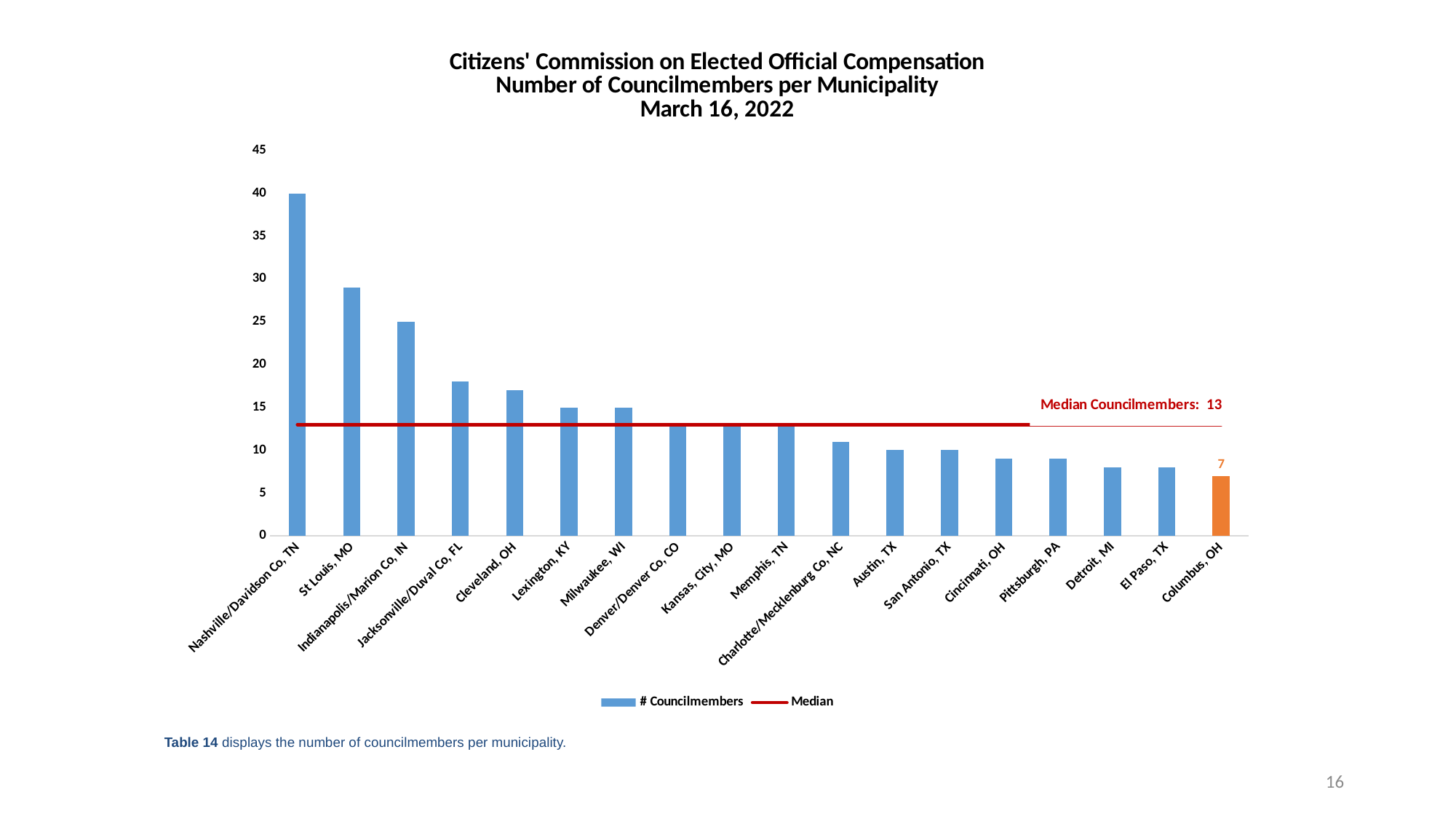
What kind of chart is shown on the slide? Combination bar and line chart (bars with a median line) What is the median number of councilmembers shown on the chart? 13 Which municipality has the highest number of councilmembers? Nashville/Davidson Co, TN Which municipality has the lowest number of councilmembers? Columbus, OH How many municipalities are shown on the chart? 18 Which has more councilmembers, Cleveland, OH or Memphis, TN? Cleveland, OH How many councilmembers does Nashville/Davidson Co, TN have according to the chart? 40 Do the number of councilmembers rise or fall moving from left to right along the x axis? Fall Is the number of councilmembers for St Louis, MO greater or less than 25? greater How many councilmembers does Columbus, OH have according to the chart? 7 How many series does the legend list? 2 Is the number of councilmembers for Detroit, MI greater or less than 10? less